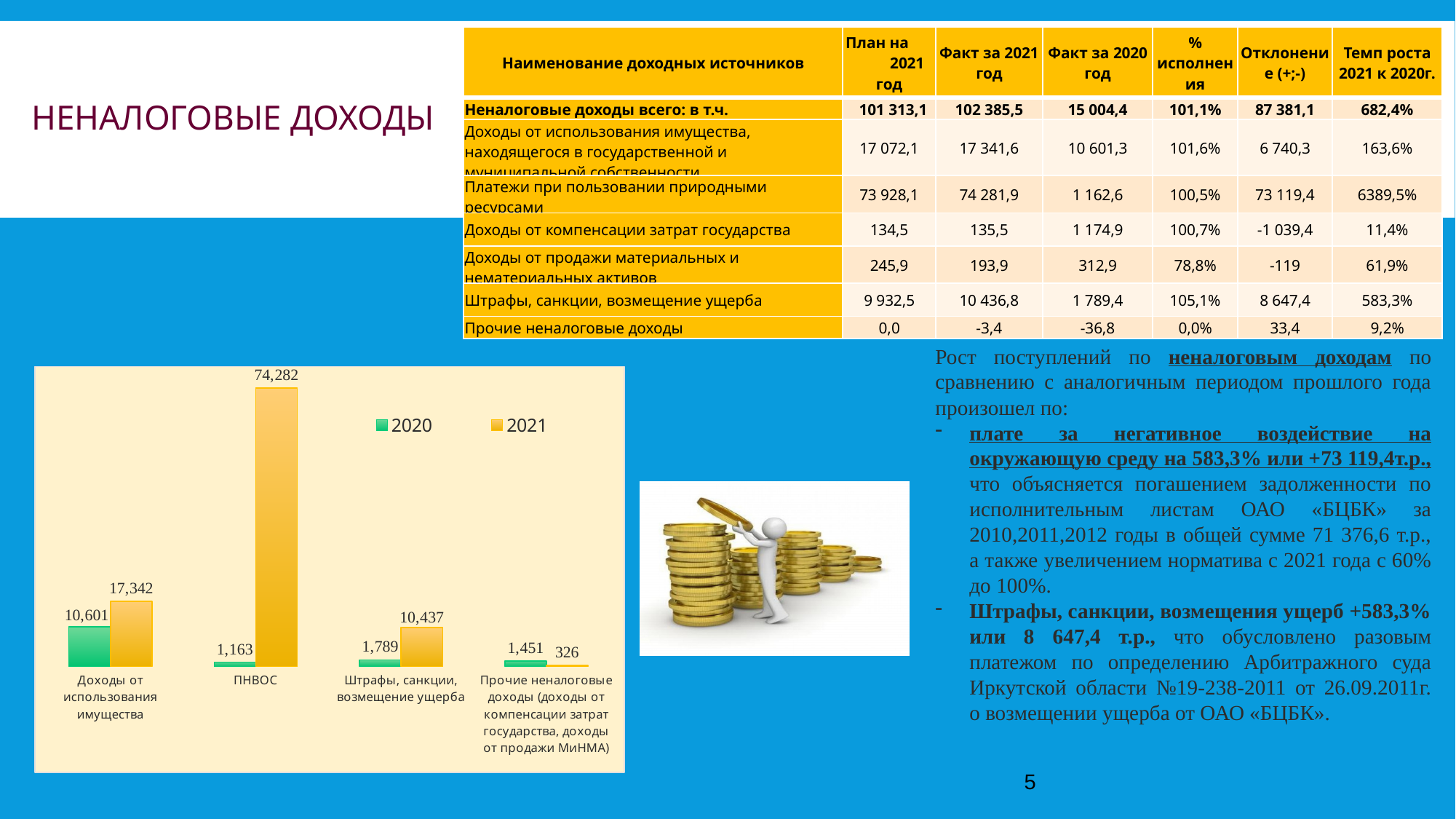
What is the 2021 value for ПНВОС in the chart? 74,282 Which colour represents the 2020 series in the chart? green What is the 2020 value for Доходы от использования имущества in the chart? 10,601 What type of chart is shown on the slide? bar chart What is the 2021 value for Штрафы, санкции, возмещение ущерба in the chart? 10,437 Which category has the lowest 2021 value in the chart? Прочие неналоговые доходы What is the difference between the 2021 and 2020 values for ПНВОС in the chart? 73,119 What is the 2020 value for Прочие неналоговые доходы in the chart? 1,451 For Прочие неналоговые доходы, which is larger in the chart: the 2020 value or the 2021 value? 2020 Which category has the highest 2021 value in the chart? ПНВОС How many series does the chart legend list? 2 How many categories are shown on the x axis of the chart? 4